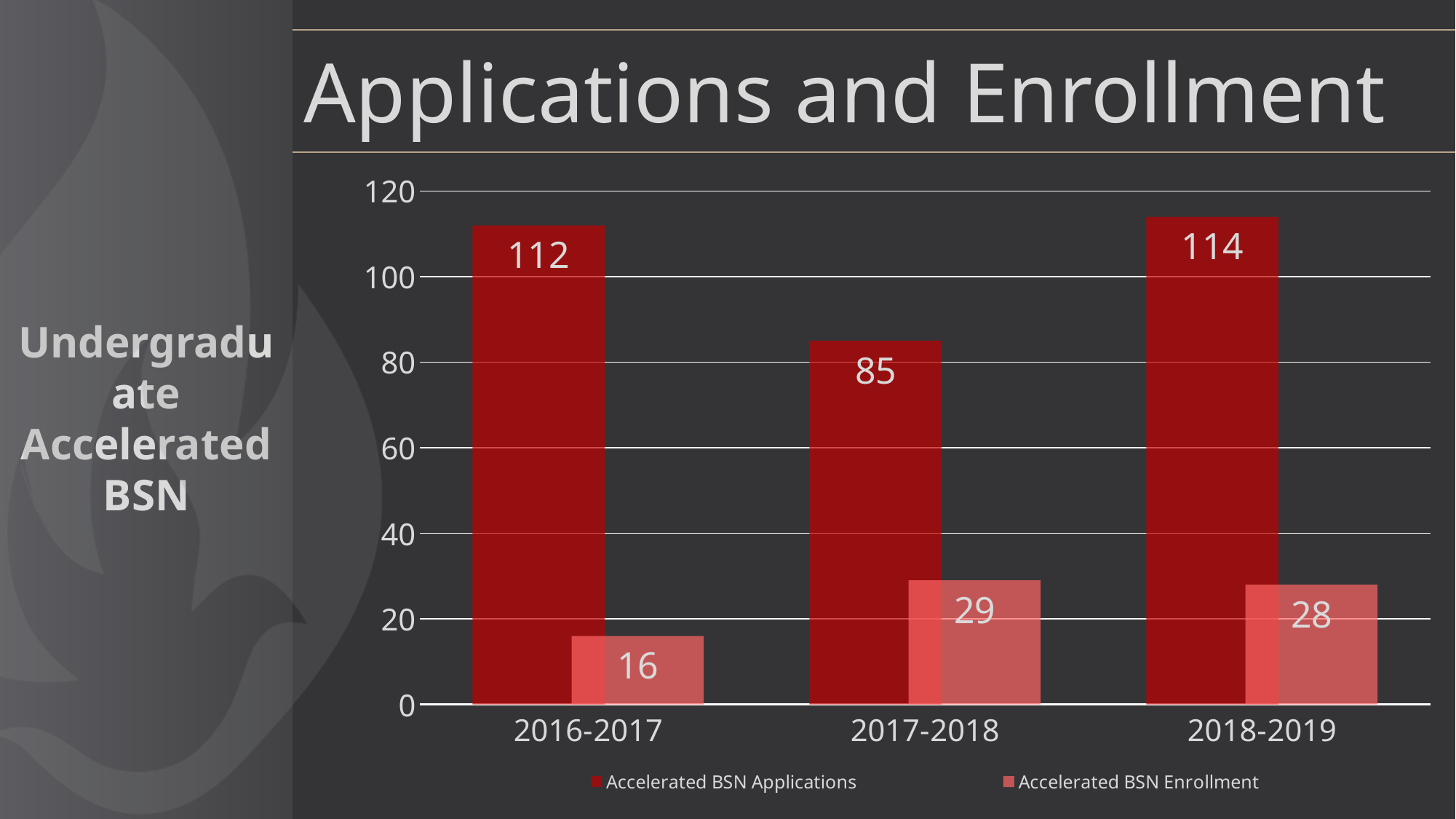
How many year categories are shown on the x axis? 3 Is the value for Accelerated BSN Applications in 2017-2018 greater or less than 100? less Which year has the highest Accelerated BSN Applications? 2018-2019 What is the value for Accelerated BSN Enrollment in 2018-2019? 28 What kind of chart is shown on the slide? bar chart What is the value for Accelerated BSN Enrollment in 2017-2018? 29 How many series does the legend list? 2 Which is larger: Accelerated BSN Applications in 2016-2017 or in 2017-2018? 2016-2017 What is the title of the chart? Applications and Enrollment Which year has the lowest Accelerated BSN Enrollment? 2016-2017 What is the value for Accelerated BSN Applications in 2016-2017? 112 What is the difference between Accelerated BSN Applications and Accelerated BSN Enrollment in 2017-2018? 56